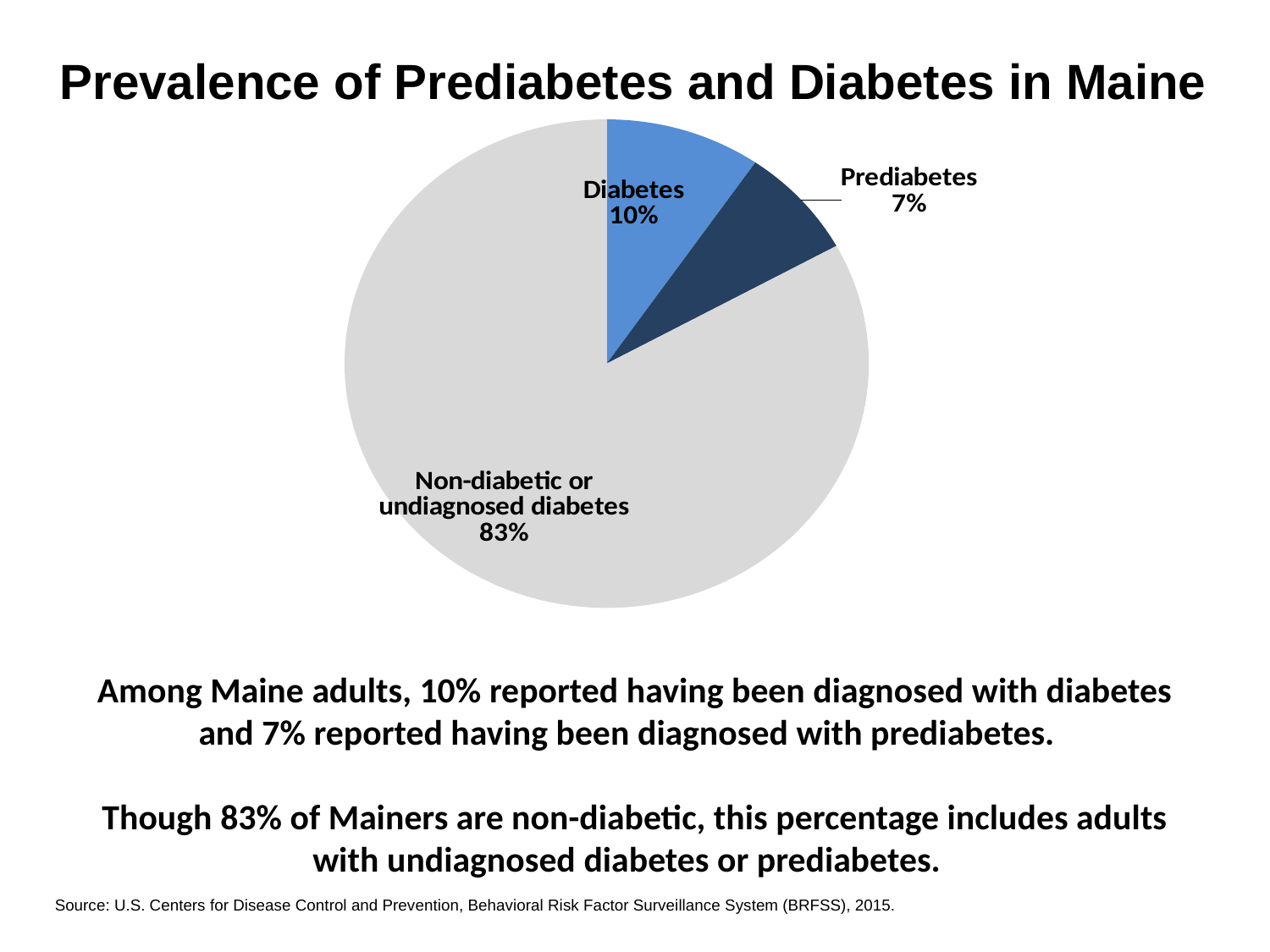
What is the difference in percentage points between the Diabetes slice and the Prediabetes slice? 3 What is the combined share of the Diabetes and Prediabetes slices? 17% Which slice of the pie is the smallest? Prediabetes Which slice of the pie is the largest? Non-diabetic or undiagnosed diabetes What colour is the Non-diabetic or undiagnosed diabetes slice? Light grey Which is larger, the Diabetes slice or the Prediabetes slice? Diabetes How many slices does the pie chart have? 3 What percentage of the pie is labelled Non-diabetic or undiagnosed diabetes? 83% What is the title of the chart? Prevalence of Prediabetes and Diabetes in Maine What percentage of the pie is labelled Diabetes? 10% What kind of chart is shown on the slide? Pie chart What percentage of the pie is labelled Prediabetes? 7%